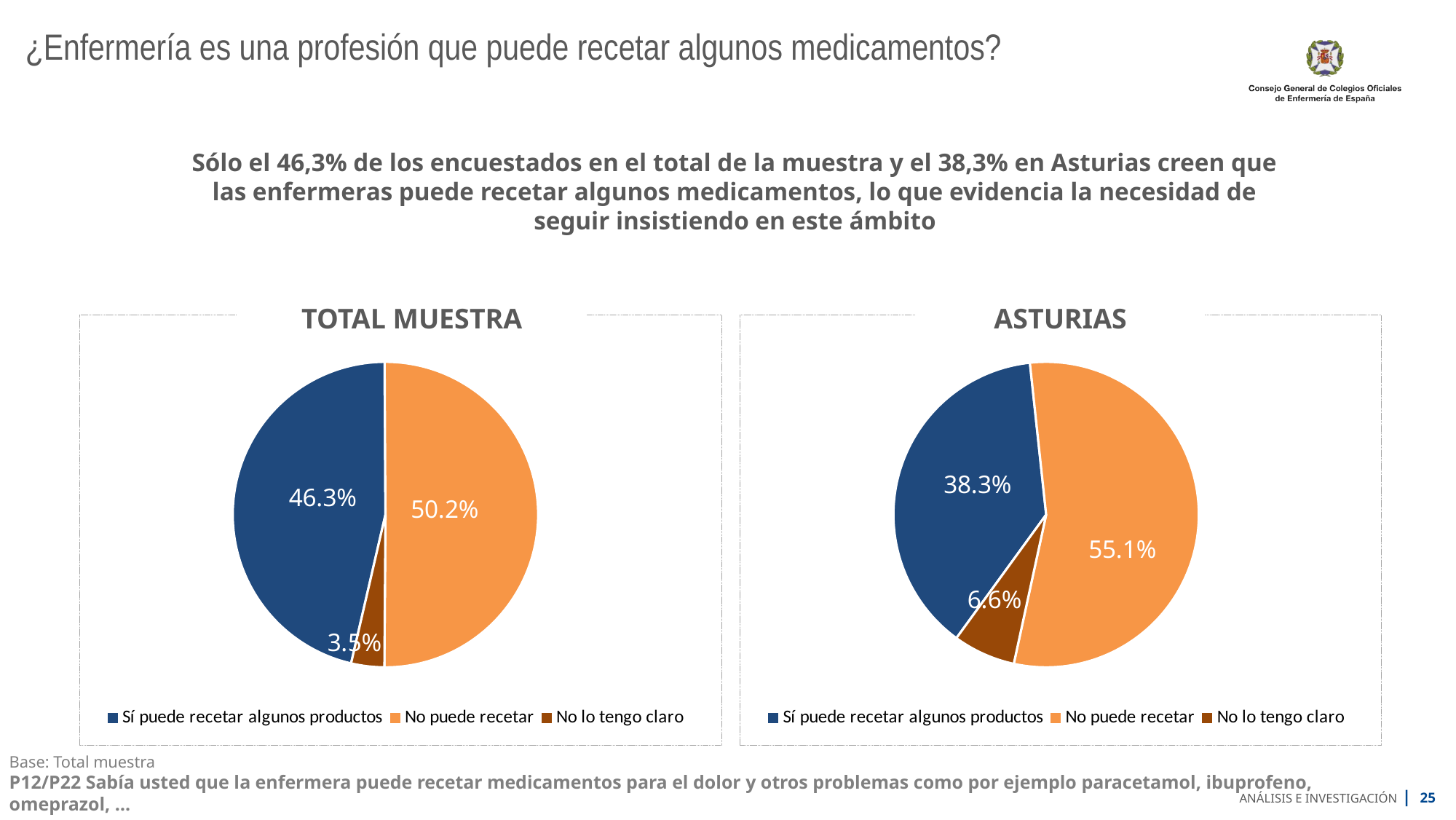
What is the difference between 'No puede recetar' and 'Sí puede recetar algunos productos' in the ASTURIAS chart? 16.8% In the TOTAL MUESTRA chart, what percentage corresponds to 'Sí puede recetar algunos productos'? 46.3% Which is larger in the TOTAL MUESTRA chart: 'Sí puede recetar algunos productos' or 'No puede recetar'? No puede recetar In the ASTURIAS chart, what colour represents 'No lo tengo claro'? Brown How many slices does the TOTAL MUESTRA pie chart have? 3 In the TOTAL MUESTRA chart, which category has the smallest share? No lo tengo claro In the TOTAL MUESTRA chart, what percentage corresponds to 'No puede recetar'? 50.2% In the ASTURIAS chart, what percentage corresponds to 'No lo tengo claro'? 6.6% Is the 'No lo tengo claro' share larger in the TOTAL MUESTRA chart or in the ASTURIAS chart? ASTURIAS What type of chart is used for ASTURIAS? Pie chart In the ASTURIAS chart, which category has the largest share? No puede recetar In the ASTURIAS chart, what percentage corresponds to 'No puede recetar'? 55.1%